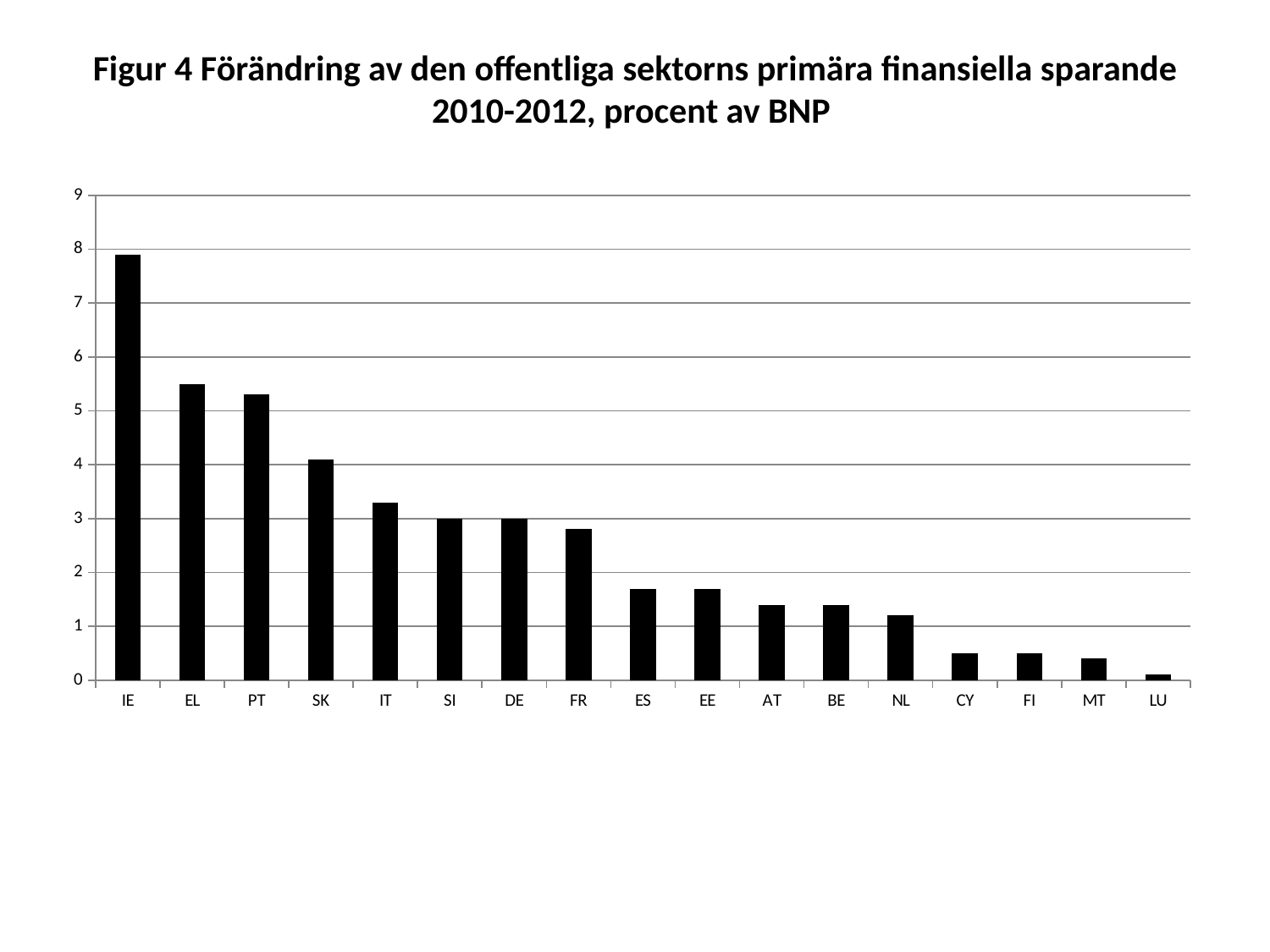
What is the title of the chart? Figur 4 Förändring av den offentliga sektorns primära finansiella sparande 2010-2012, procent av BNP How many countries are shown on the x axis? 17 Is the value for IE greater or less than 7? greater Do the values rise or fall from left to right along the x axis? fall Which has the larger value, SK or IT? SK Which has the larger value, IE or EL? IE Which country has the highest value in the chart? IE Is the value for FR greater or less than 3? less What kind of chart is shown on the slide? bar chart Which country has the lowest value in the chart? LU Is the value for CY greater or less than 1? less